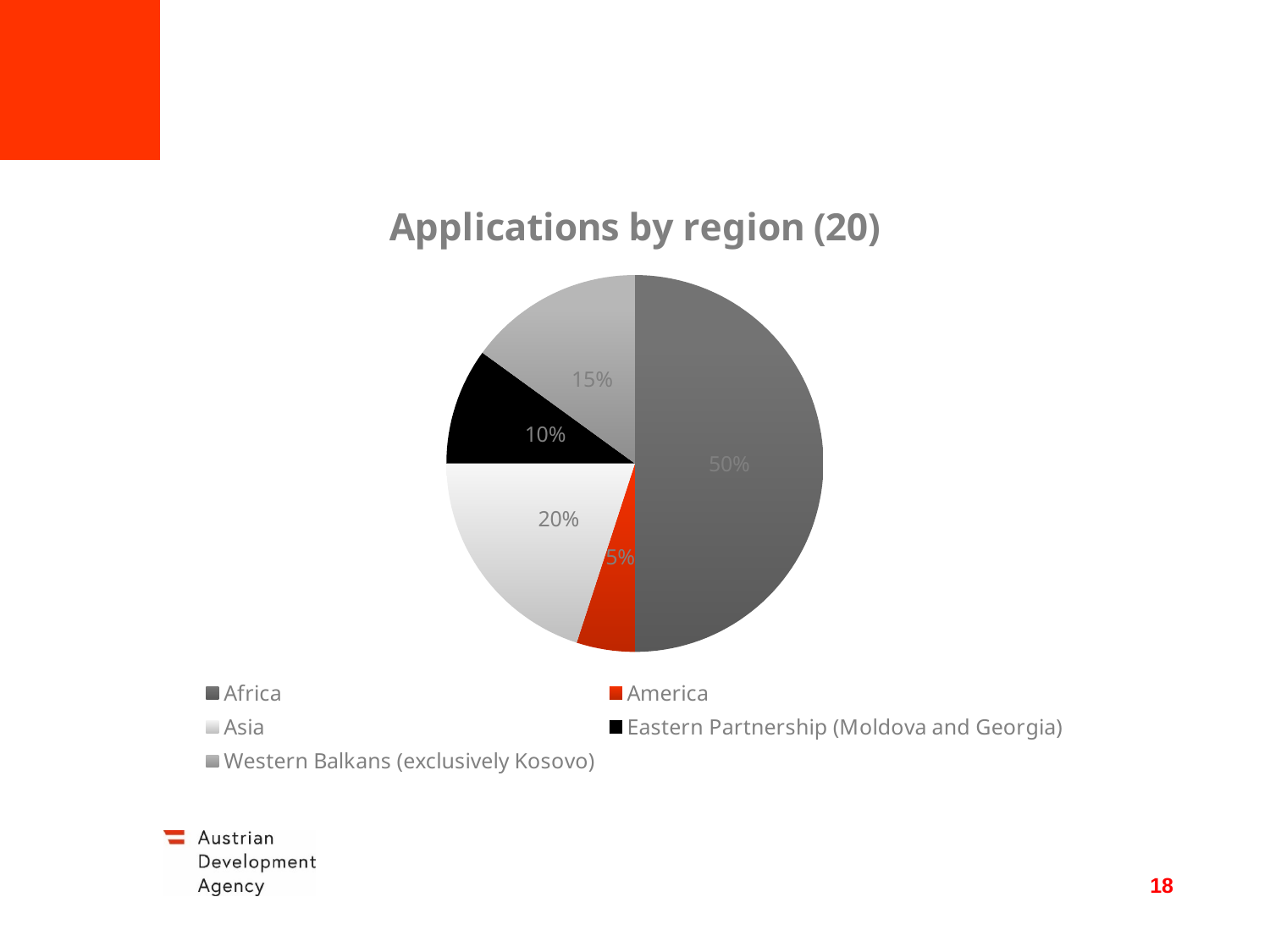
What is the title of the chart? Applications by region (20) Which region has the largest share of applications? Africa How many percentage points larger is Africa's share than Asia's share? 30 What share of applications does America account for? 5% What share of applications does Western Balkans (exclusively Kosovo) account for? 15% Which has a larger share of applications, Asia or Western Balkans (exclusively Kosovo)? Asia How many regions are shown in the pie chart? 5 What share of applications does Asia account for? 20% What share of applications does Africa account for? 50% Which region has the smallest share of applications? America What share of applications does Eastern Partnership (Moldova and Georgia) account for? 10% What type of chart is shown on the slide? Pie chart